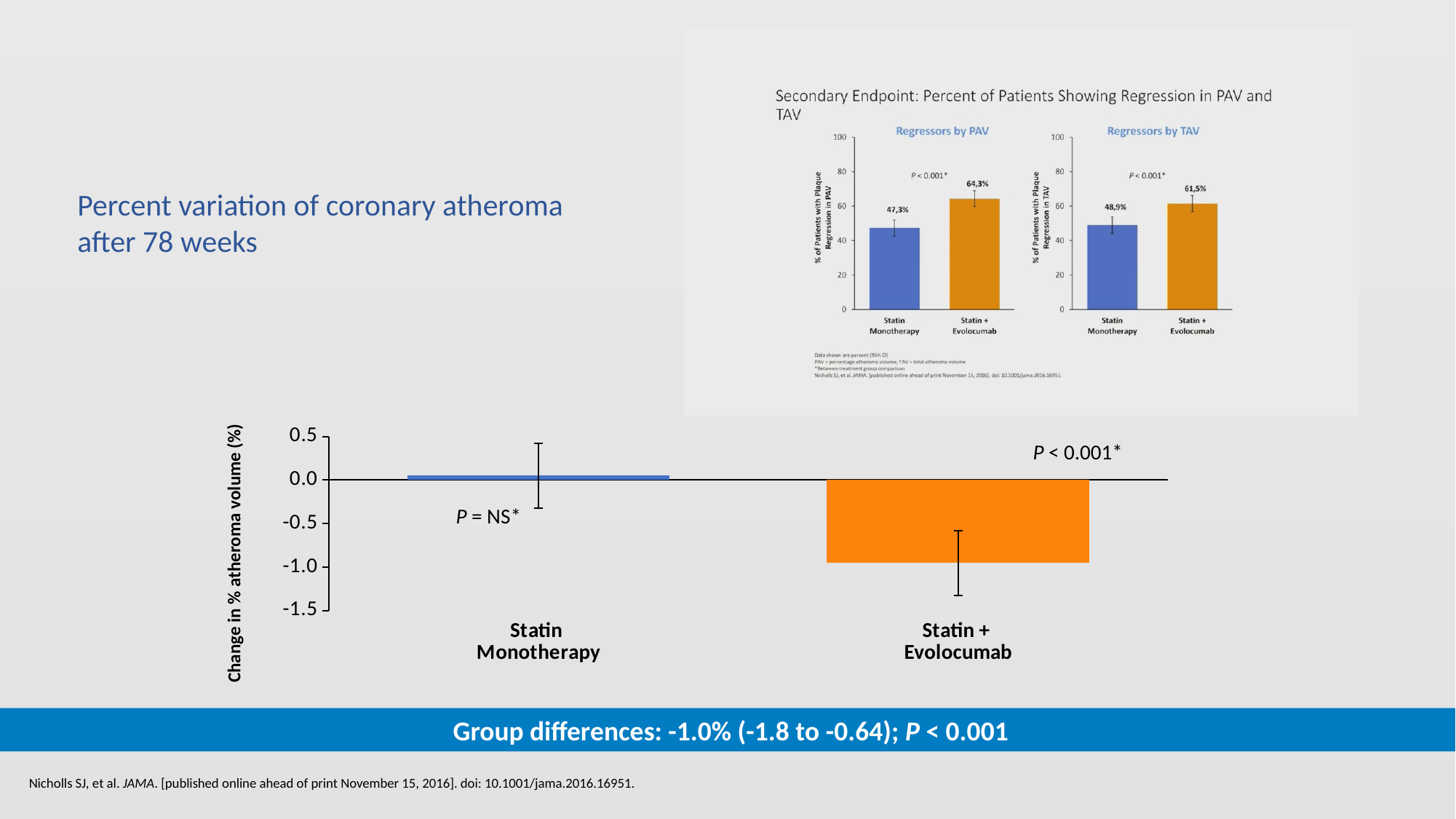
In the Regressors by PAV chart (top right), what percent of patients showed plaque regression with Statin Monotherapy? 47,3% In the bottom chart (Percent variation of coronary atheroma after 78 weeks), what kind of chart is shown? bar chart In the Regressors by PAV chart (top right), what percent of patients showed plaque regression with Statin + Evolocumab? 64,3% In the bottom chart (Percent variation of coronary atheroma after 78 weeks), is the value for Statin Monotherapy greater or less than 0.5? less In the Regressors by TAV chart (top right), what percent of patients showed plaque regression with Statin + Evolocumab? 61,5% In the bottom chart (Percent variation of coronary atheroma after 78 weeks), what is the y-axis label? Change in % atheroma volume (%) In the bottom chart (Percent variation of coronary atheroma after 78 weeks), how many treatment groups are plotted? 2 In the bottom chart (Percent variation of coronary atheroma after 78 weeks), is the value for Statin + Evolocumab greater or less than -0.5? less In the bottom chart (Percent variation of coronary atheroma after 78 weeks), which group has the lowest change in % atheroma volume? Statin + Evolocumab In the Regressors by TAV chart (top right), what is the difference in percent of regressors between Statin + Evolocumab and Statin Monotherapy? 12,6% In the Regressors by PAV chart (top right), which group has the higher percent of patients with plaque regression? Statin + Evolocumab In the bottom chart (Percent variation of coronary atheroma after 78 weeks), which group has the larger change in % atheroma volume, Statin Monotherapy or Statin + Evolocumab? Statin Monotherapy